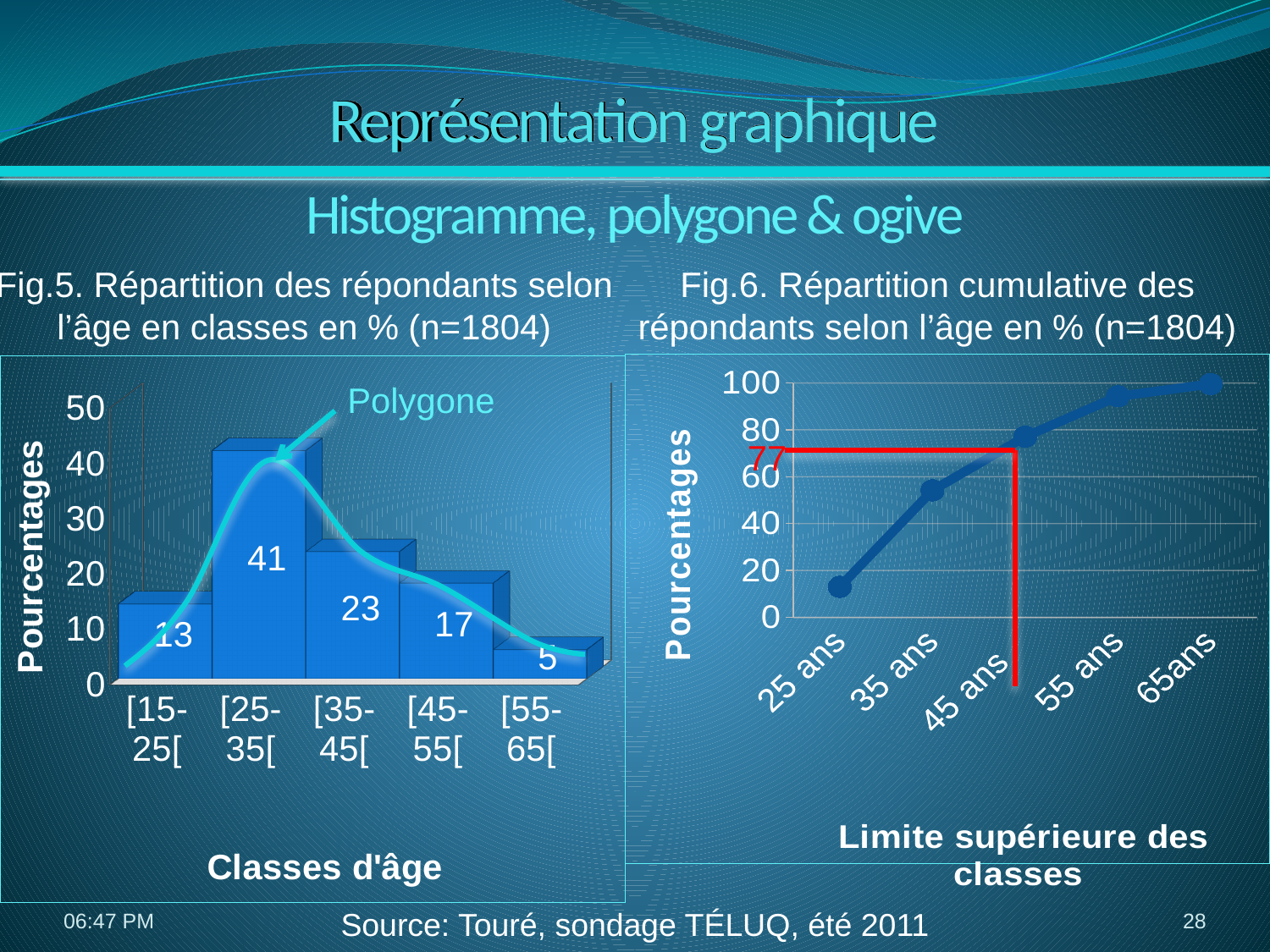
In Fig.5, how many age classes are shown on the x axis? 5 In Fig.5, what is the percentage for the age class [55-65[? 5 In Fig.5, which is larger, the value for [15-25[ or the value for [45-55[? [45-55[ In Fig.5, what is the percentage for the age class [25-35[? 41 In Fig.5, what is the label of the y axis? Pourcentages In Fig.6, is the value at 35 ans greater or less than 40? greater In Fig.5, which age class has the lowest percentage? [55-65[ In Fig.5, which age class has the highest percentage? [25-35[ In Fig.5, what is the difference between the percentages for [35-45[ and [45-55[? 6 What kind of chart is Fig.5? bar chart In Fig.6, is the value at 25 ans greater or less than 20? less In Fig.6, do the values rise or fall from 25 ans to 65ans? rise